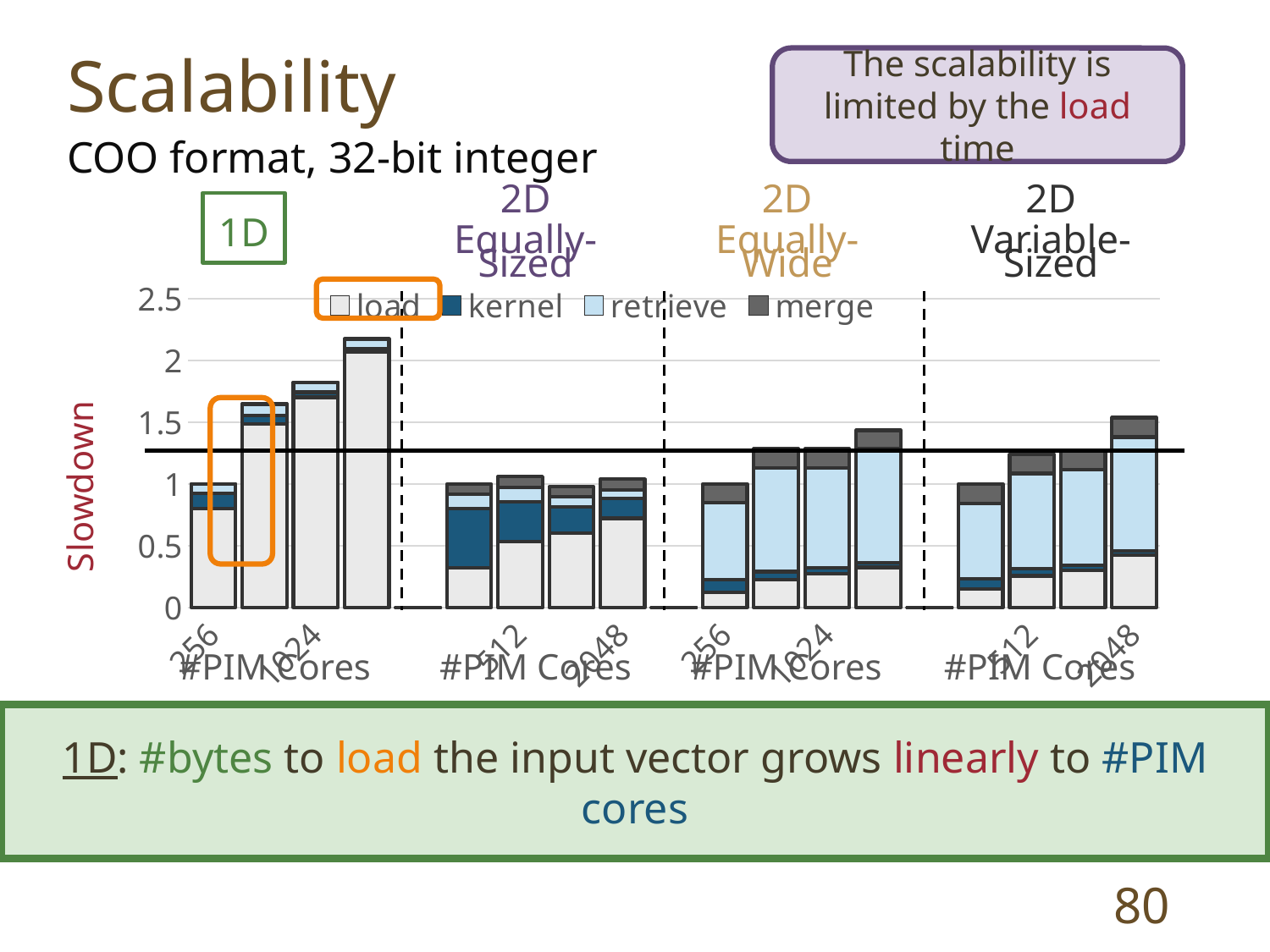
What is the label of the chart's vertical axis? Slowdown What are the four series named in the chart legend? load, kernel, retrieve, merge Which of the four groups contains the tallest stacked bar in the chart? 1D How many series does the chart legend list? 4 Is the total slowdown of the 1D bar at 2048 PIM cores greater or less than 2? greater How many groups of bars (partitioning schemes) does the chart show? 4 Is the total slowdown of the 1D bar at 256 PIM cores greater or less than 1.5? less How many bars are plotted in the 1D group of the chart? 4 In the 1D group, do the stacked bar totals rise or fall as #PIM cores increases from 256 to 2048? rise Is the total slowdown of the 2D Equally-Wide bar at 2048 PIM cores greater or less than 1? greater In the 1D group, which #PIM cores value has the tallest stacked bar? 2048 What kind of chart is shown on the slide? stacked bar chart